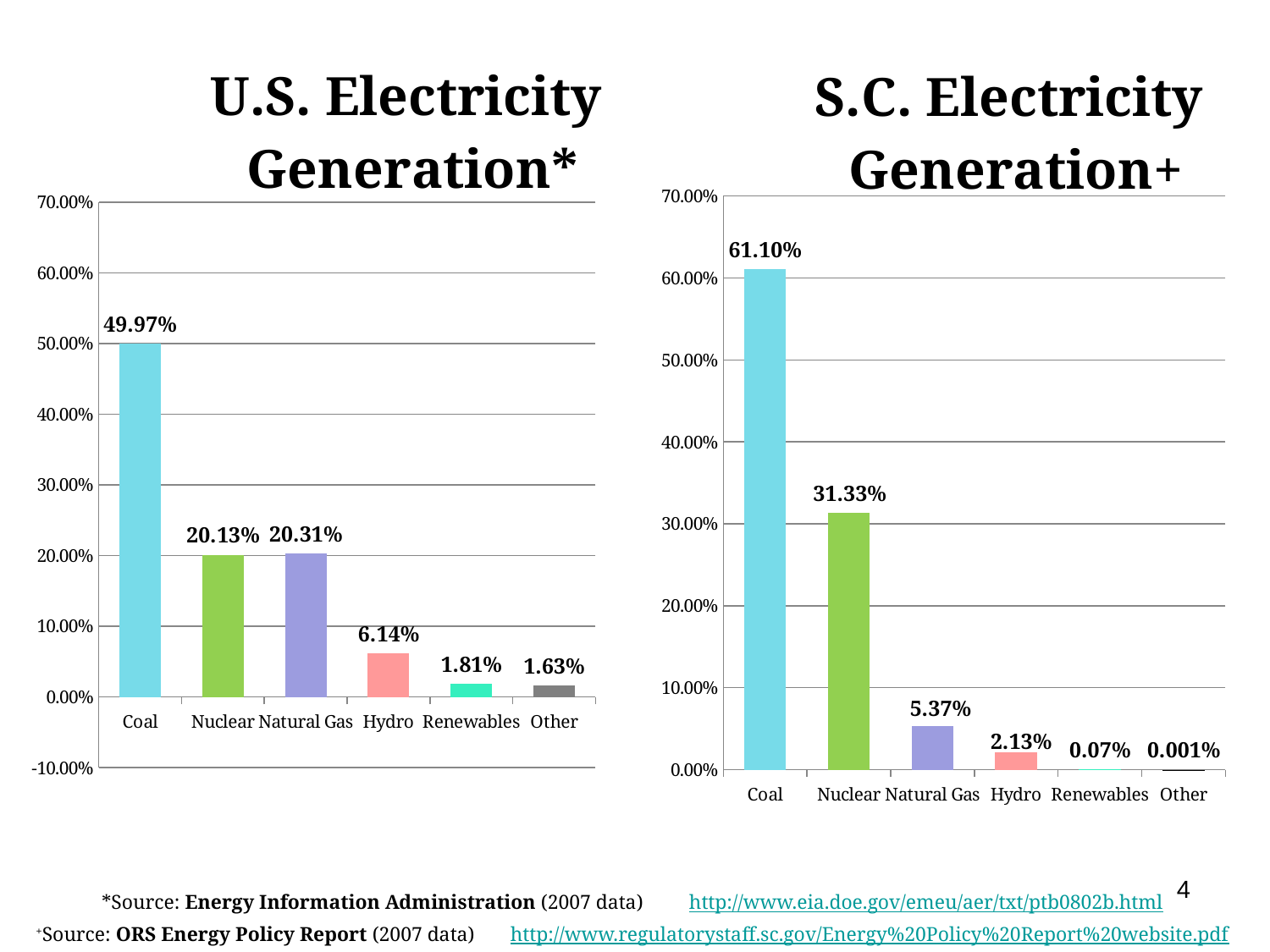
In the U.S. Electricity Generation chart, what is the value for Coal? 49.97% In the S.C. Electricity Generation chart, what is the difference between the Coal value and the Natural Gas value? 55.73% In the U.S. Electricity Generation chart, which category has the highest value? Coal How many categories are shown in the U.S. Electricity Generation chart? 6 In the S.C. Electricity Generation chart, which category has the lowest value? Other In the S.C. Electricity Generation chart, what is the value for Renewables? 0.07% What kind of chart is the S.C. Electricity Generation chart? bar chart In the S.C. Electricity Generation chart, what is the value for Nuclear? 31.33% In the U.S. Electricity Generation chart, which is larger, the value for Hydro or the value for Renewables? Hydro In the U.S. Electricity Generation chart, what is the difference between the Coal value and the Nuclear value? 29.84% In the U.S. Electricity Generation chart, what is the value for Other? 1.63% In the S.C. Electricity Generation chart, is the value for Coal greater or less than 60.00%? greater